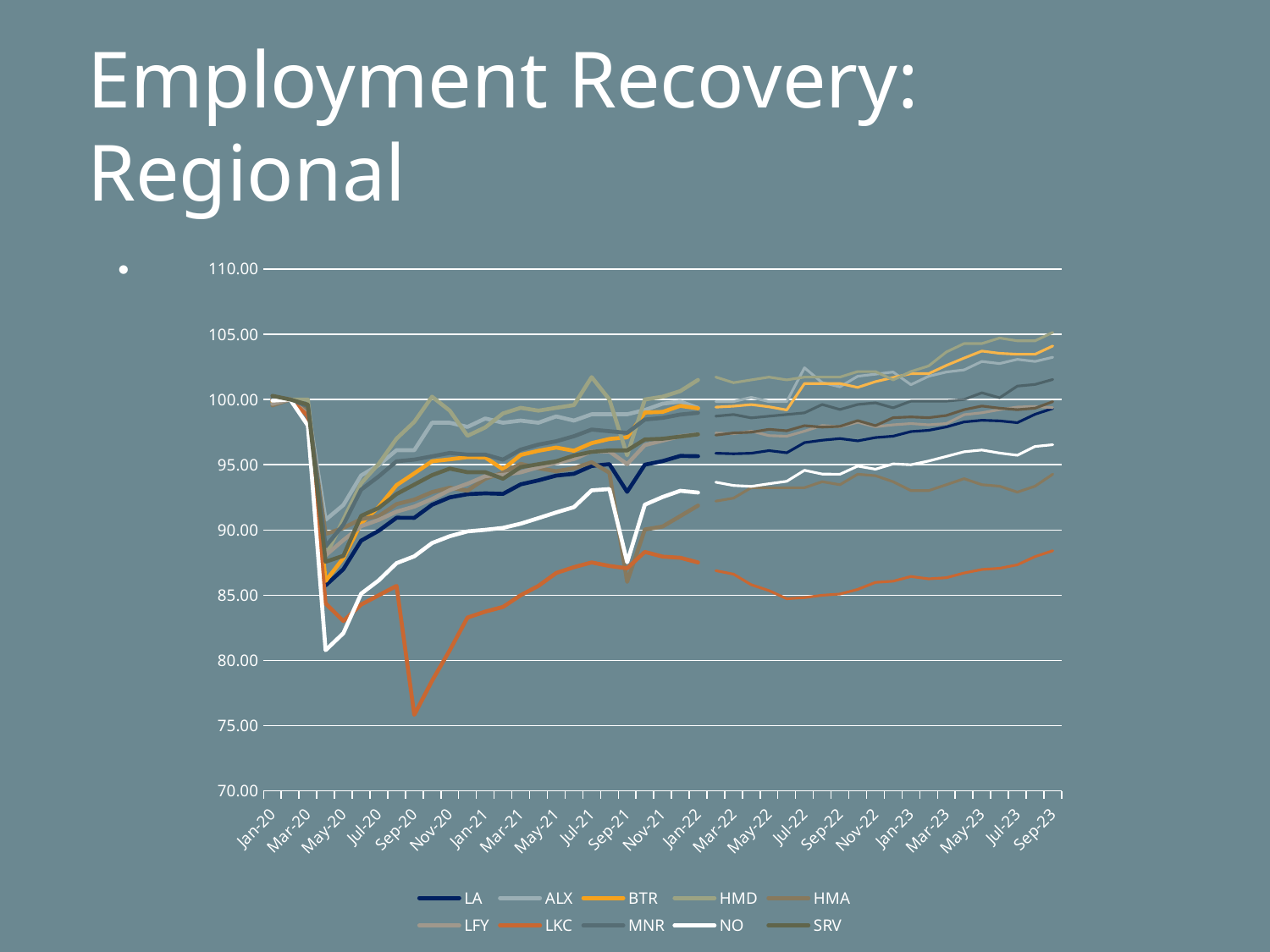
Which series has the lowest value at Sep-23? LKC Which series falls to the lowest value around Sep-20? LKC What is the title of the slide containing the chart? Employment Recovery: Regional Is the value for LKC at Sep-20 greater or less than 80.00? less At Sep-23, which series is higher, LKC or BTR? BTR Is the value for BTR at Sep-23 greater or less than 100.00? greater Is the value for NO at May-20 greater or less than 85.00? less How many series does the legend list? 10 What kind of chart is shown on the slide? line chart Does the BTR series rise or fall overall from Jan-22 to Sep-23? rise